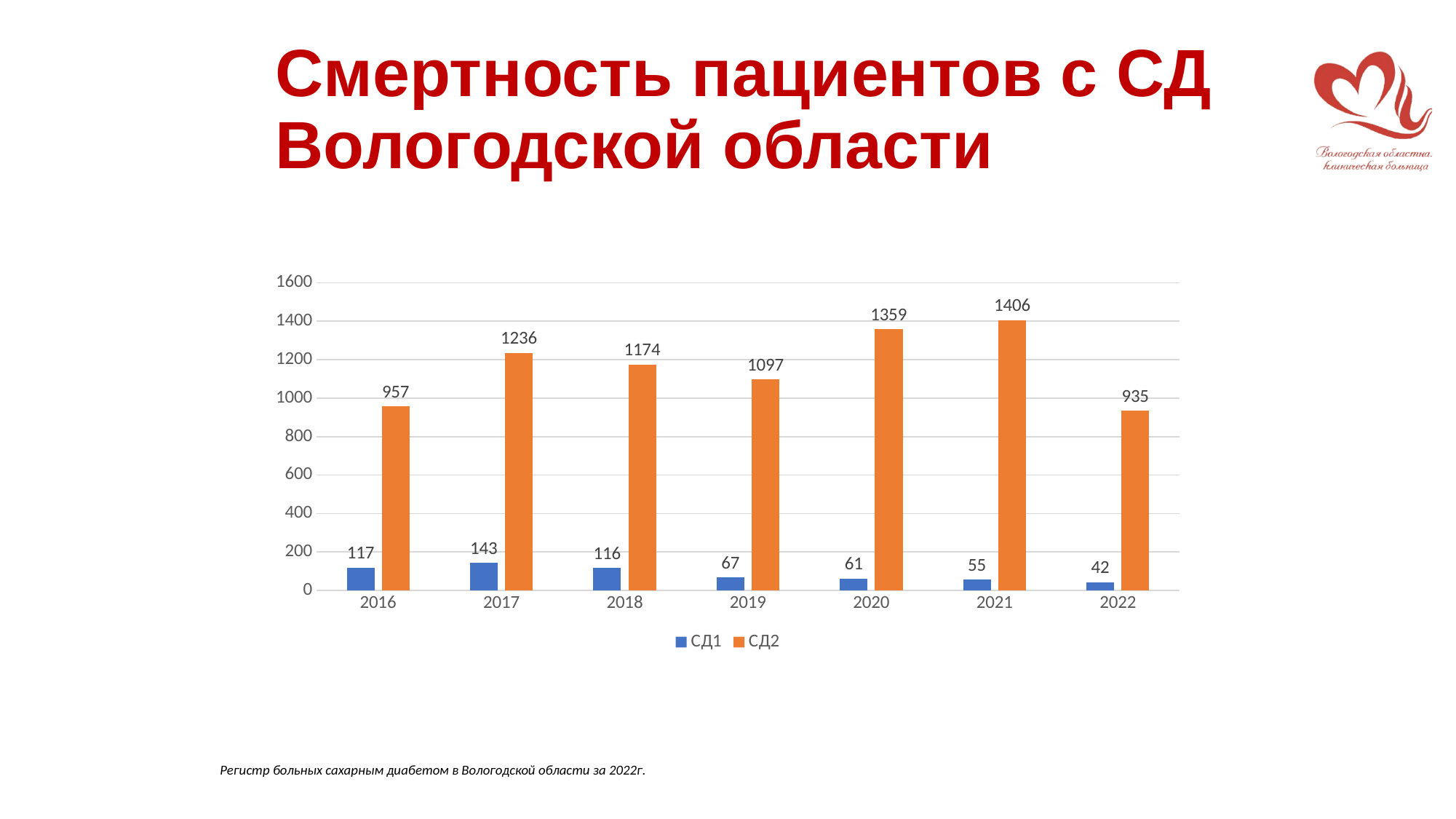
In which year is the СД2 value lowest? 2022 What is the value for СД2 in 2021? 1406 What is the difference between the СД2 values for 2021 and 2022? 471 What is the value for СД1 in 2019? 67 In which year is the СД1 value highest? 2017 Which is larger, the СД1 value for 2016 or for 2018? 2016 How many years are shown on the x axis? 7 How many series does the legend list? 2 What colour are the СД2 bars? orange What is the value for СД2 in 2016? 957 Does the СД1 value rise or fall from 2019 to 2022? fall What kind of chart is shown on the slide? bar chart